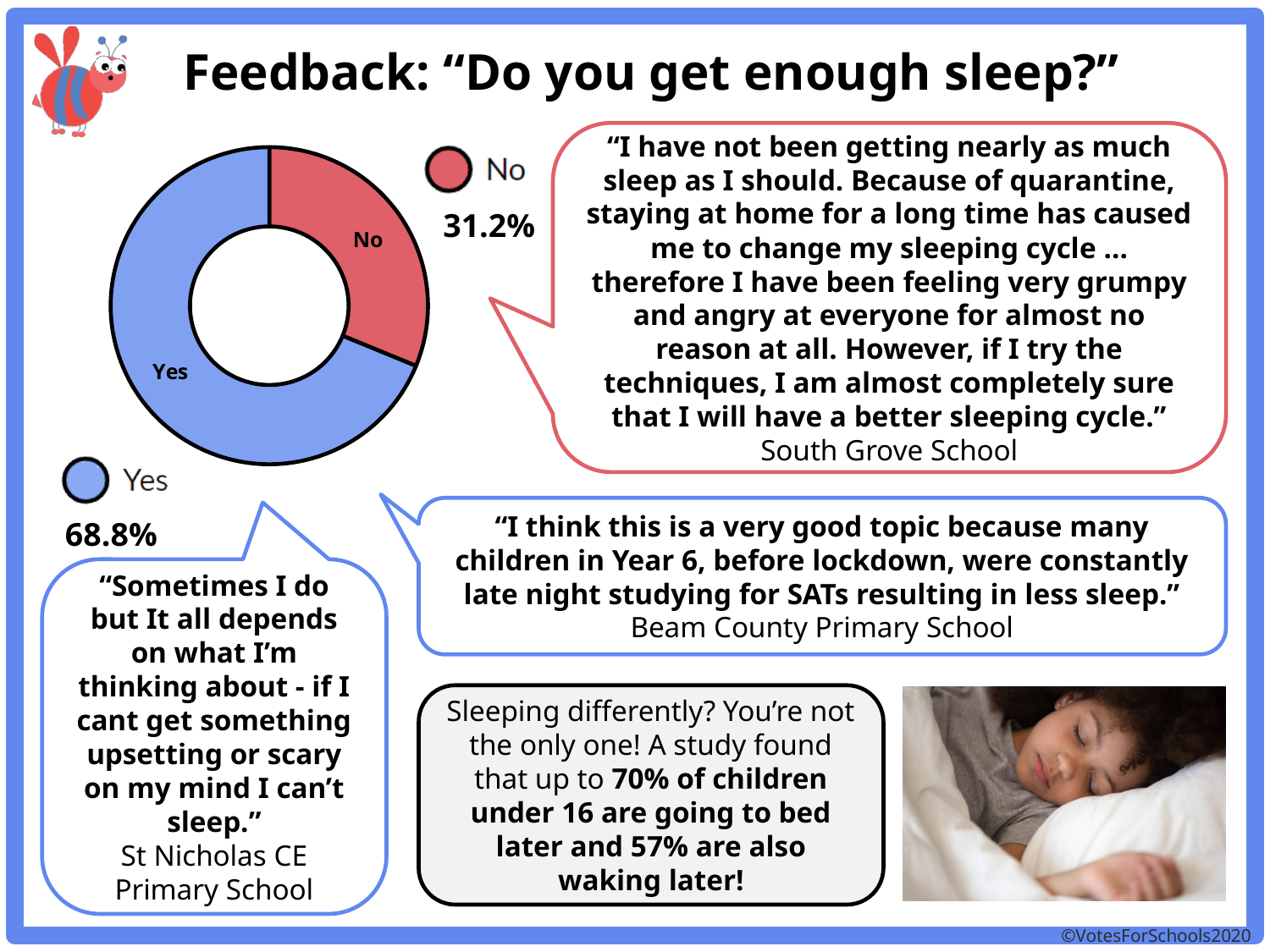
What percentage of respondents answered "No" to "Do you get enough sleep?"? 31.2% What kind of chart is shown on the slide? Pie chart (doughnut) What colour represents the "No" response in the chart? Red Do the Yes and No shares add up to 100%? Yes What is the difference in percentage points between the Yes and No shares? 37.6 Which response has the larger share of the chart, Yes or No? Yes Which response has the smaller share of the chart? No What colour represents the "Yes" response in the chart? Blue How many categories does the chart show? 2 Is the share for "No" greater or less than 50%? less What percentage of respondents answered "Yes" to "Do you get enough sleep?"? 68.8%